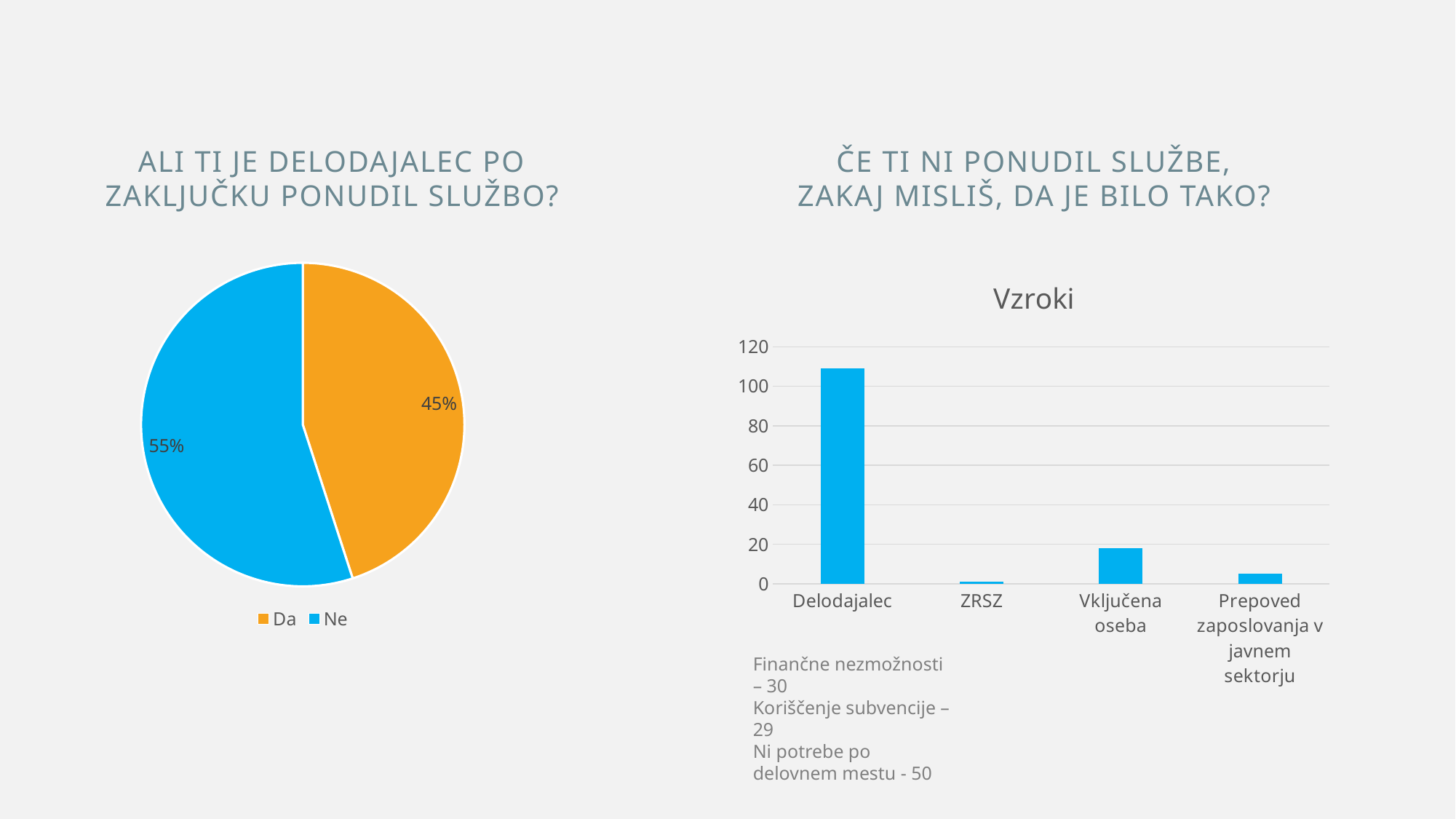
What type of chart is the chart on the left of the slide? pie chart In the "Vzroki" chart, is the value for Delodajalec greater or less than 100? greater In the pie chart on the left, which answer has the larger share, "Da" or "Ne"? Ne In the "Vzroki" chart, which category has the lowest value? ZRSZ In the pie chart on the left, what share of respondents answered "Da"? 45% In the "Vzroki" chart, how many categories are shown on the x axis? 4 In the "Vzroki" chart, which category has the highest value? Delodajalec How many entries does the legend of the pie chart on the left list? 2 In the pie chart on the left, what share of respondents answered "Ne"? 55% What type of chart is the "Vzroki" chart on the right? bar chart In the pie chart on the left, what is the difference in percentage points between the "Ne" and "Da" slices? 10